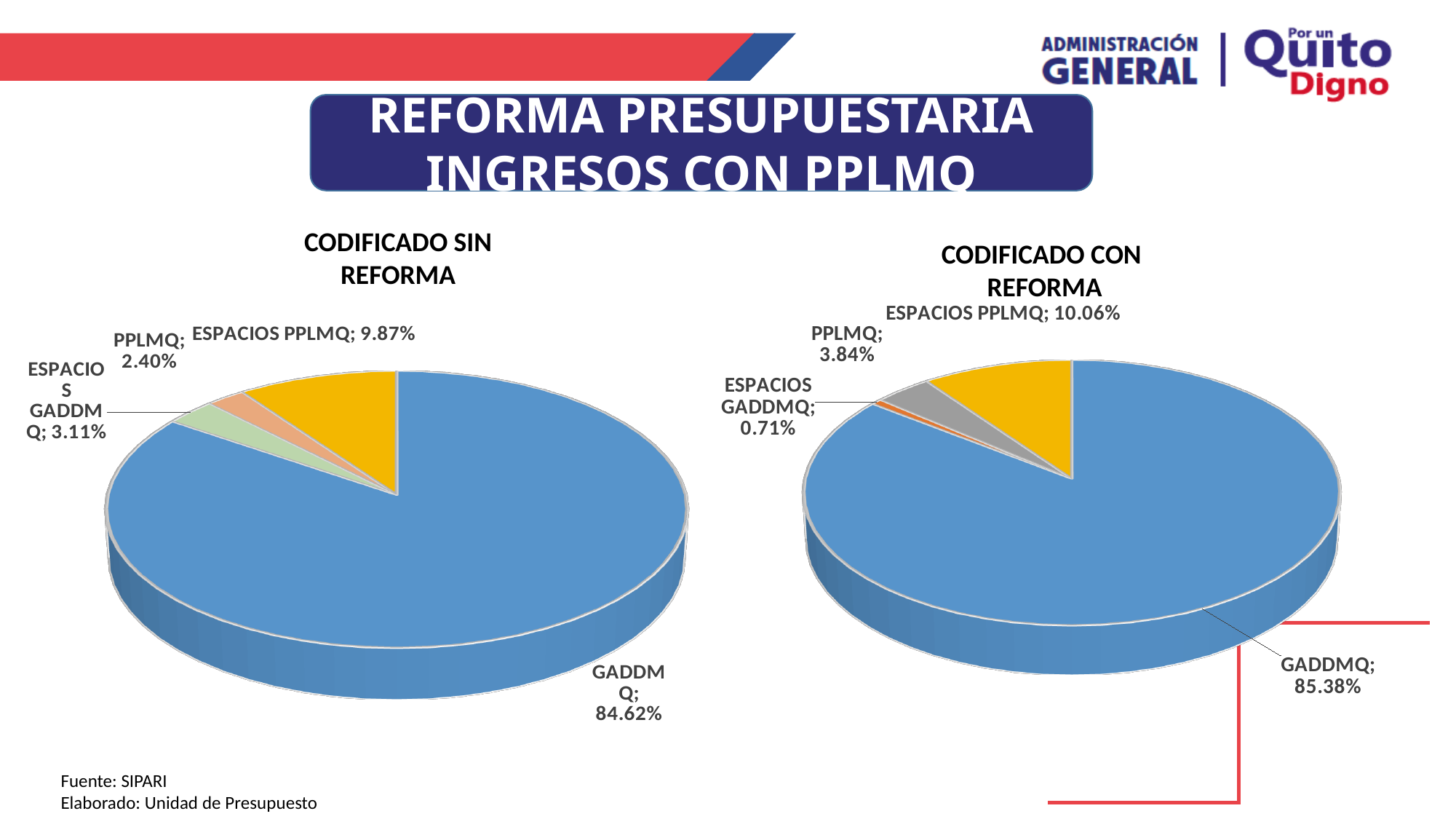
What is the difference between the GADDMQ share in the 'CODIFICADO CON REFORMA' chart and in the 'CODIFICADO SIN REFORMA' chart? 0.76% In the 'CODIFICADO CON REFORMA' chart, what share does GADDMQ have? 85.38% In the 'CODIFICADO CON REFORMA' chart, what is the value for ESPACIOS GADDMQ? 0.71% In the 'CODIFICADO CON REFORMA' chart, which category has the smallest slice? ESPACIOS GADDMQ How many slices does the 'CODIFICADO CON REFORMA' chart have? 4 In the 'CODIFICADO SIN REFORMA' chart, what is the value for PPLMQ? 2.40% In the 'CODIFICADO SIN REFORMA' chart, what is the value for ESPACIOS PPLMQ? 9.87% Which is larger: ESPACIOS PPLMQ in the 'CODIFICADO SIN REFORMA' chart or ESPACIOS PPLMQ in the 'CODIFICADO CON REFORMA' chart? CODIFICADO CON REFORMA In the 'CODIFICADO SIN REFORMA' chart, what share does GADDMQ have? 84.62% What type of chart is 'CODIFICADO SIN REFORMA'? Pie chart In the 'CODIFICADO SIN REFORMA' chart, which category has the largest slice? GADDMQ In the 'CODIFICADO CON REFORMA' chart, what is the value for PPLMQ? 3.84%